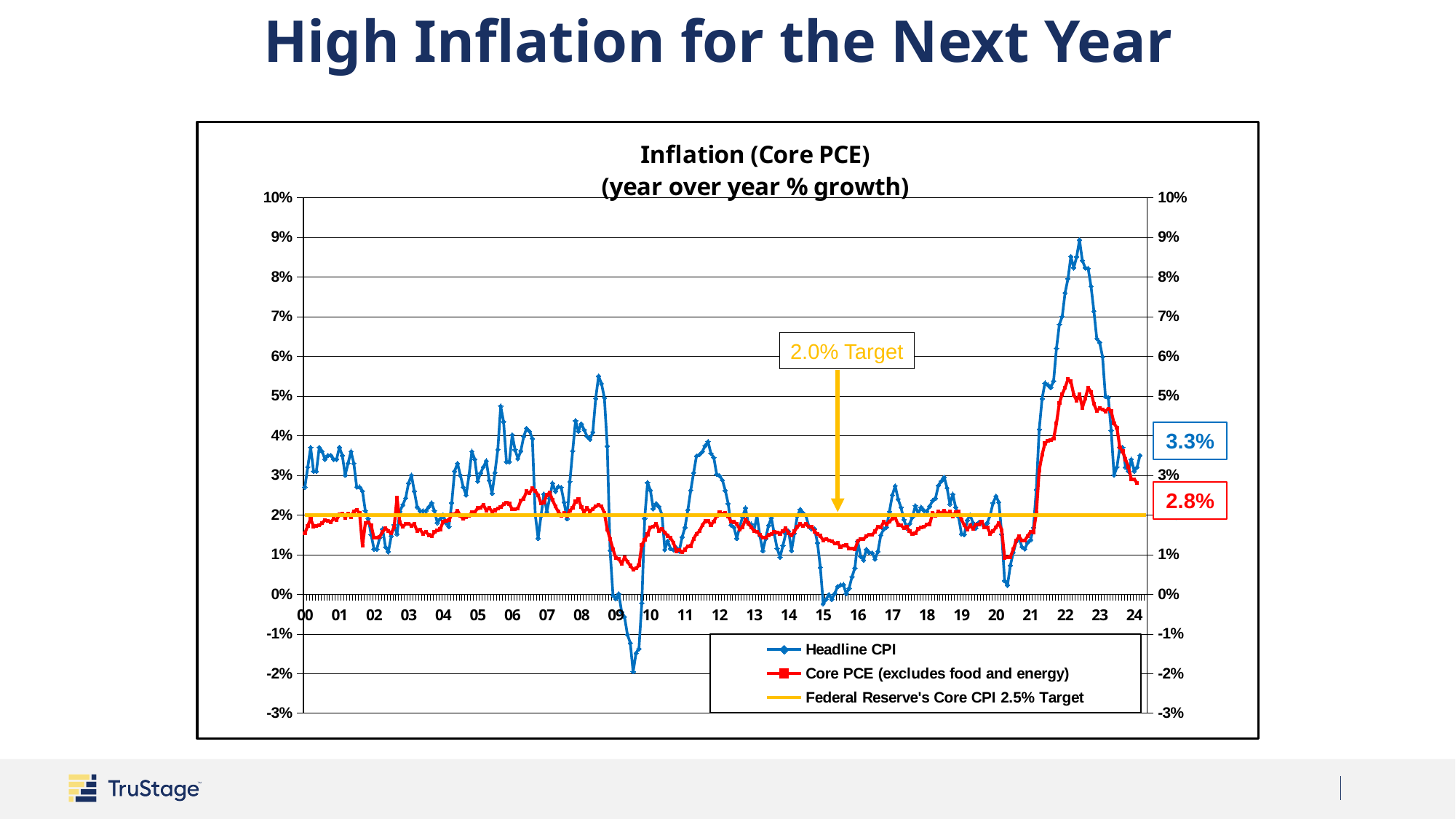
What is the latest labelled value for Headline CPI on the chart? 3.3% Does Headline CPI rise or fall from its 2022 peak to 2023? Fall What is the latest labelled value for Core PCE on the chart? 2.8% What kind of chart is shown on the slide? Line chart What is the difference between the latest labelled Headline CPI value and the latest labelled Core PCE value? 0.5 percentage points Is the peak of Headline CPI in 2022 greater or less than 8%? greater Is the peak of Core PCE in 2022 greater or less than 5%? greater How many series does the legend list? 3 What value does the yellow target line on the chart represent, according to the annotation? 2.0% Target Which is larger at the end of the chart: the labelled Headline CPI value or the labelled Core PCE value? Headline CPI Which series reaches the higher peak in 2022, Headline CPI or Core PCE? Headline CPI Is the lowest value of Headline CPI around 2009 greater or less than -1%? less